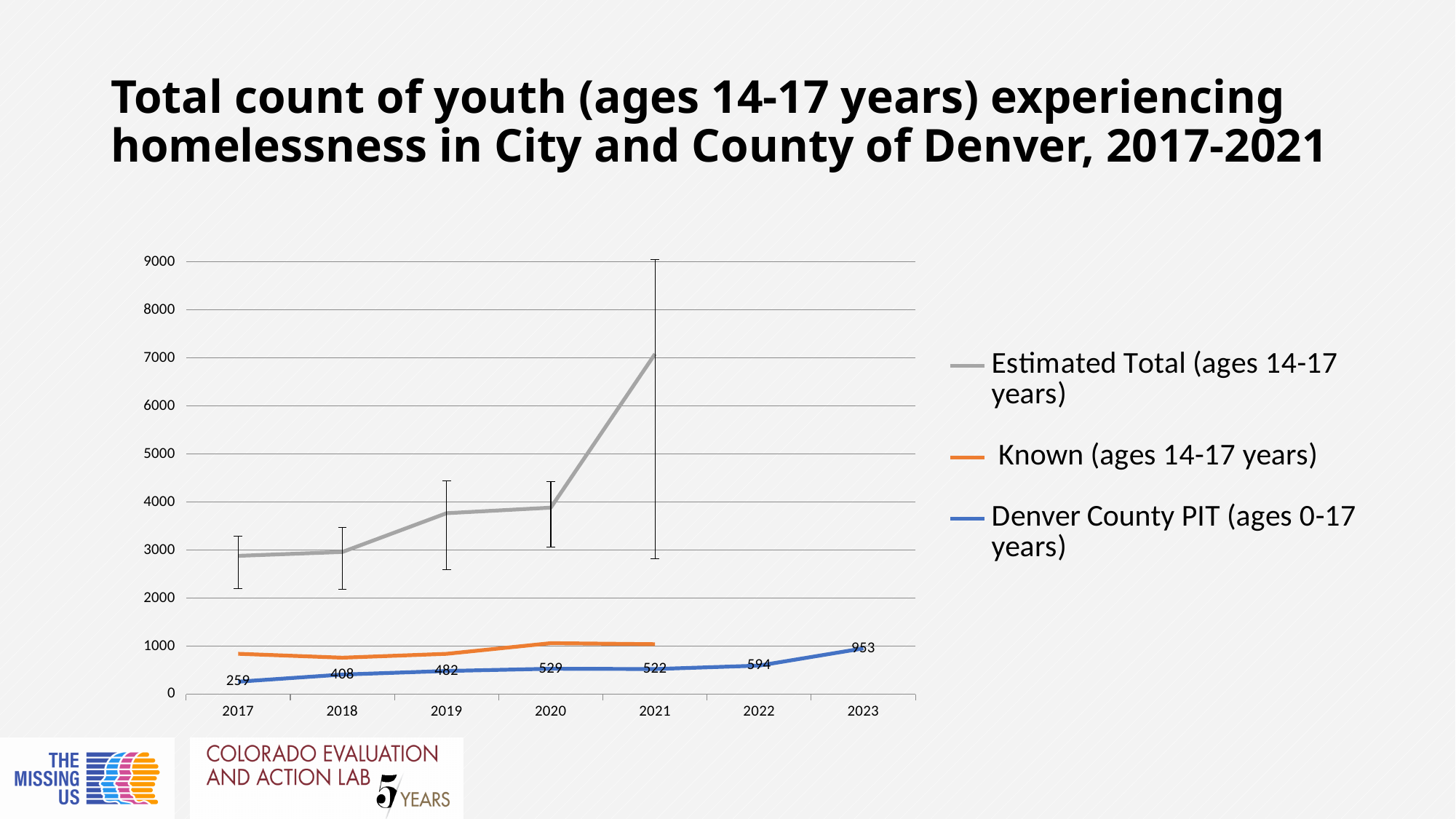
Which is larger, the Denver County PIT value for 2020 or for 2021? 2020 What is the Denver County PIT (ages 0-17 years) value for 2020? 529 What type of chart is shown on the slide? line chart In which year is the Denver County PIT (ages 0-17 years) value highest? 2023 What is the difference between the Denver County PIT values for 2023 and 2022? 359 How many years are shown on the x axis? 7 Is the Estimated Total (ages 14-17 years) value for 2021 greater or less than 6000? greater How many series does the legend list? 3 In which year is the Denver County PIT (ages 0-17 years) value lowest? 2017 What is the Denver County PIT (ages 0-17 years) value for 2017? 259 What is the Denver County PIT (ages 0-17 years) value for 2023? 953 Does the Estimated Total (ages 14-17 years) line rise or fall from 2017 to 2021? rise